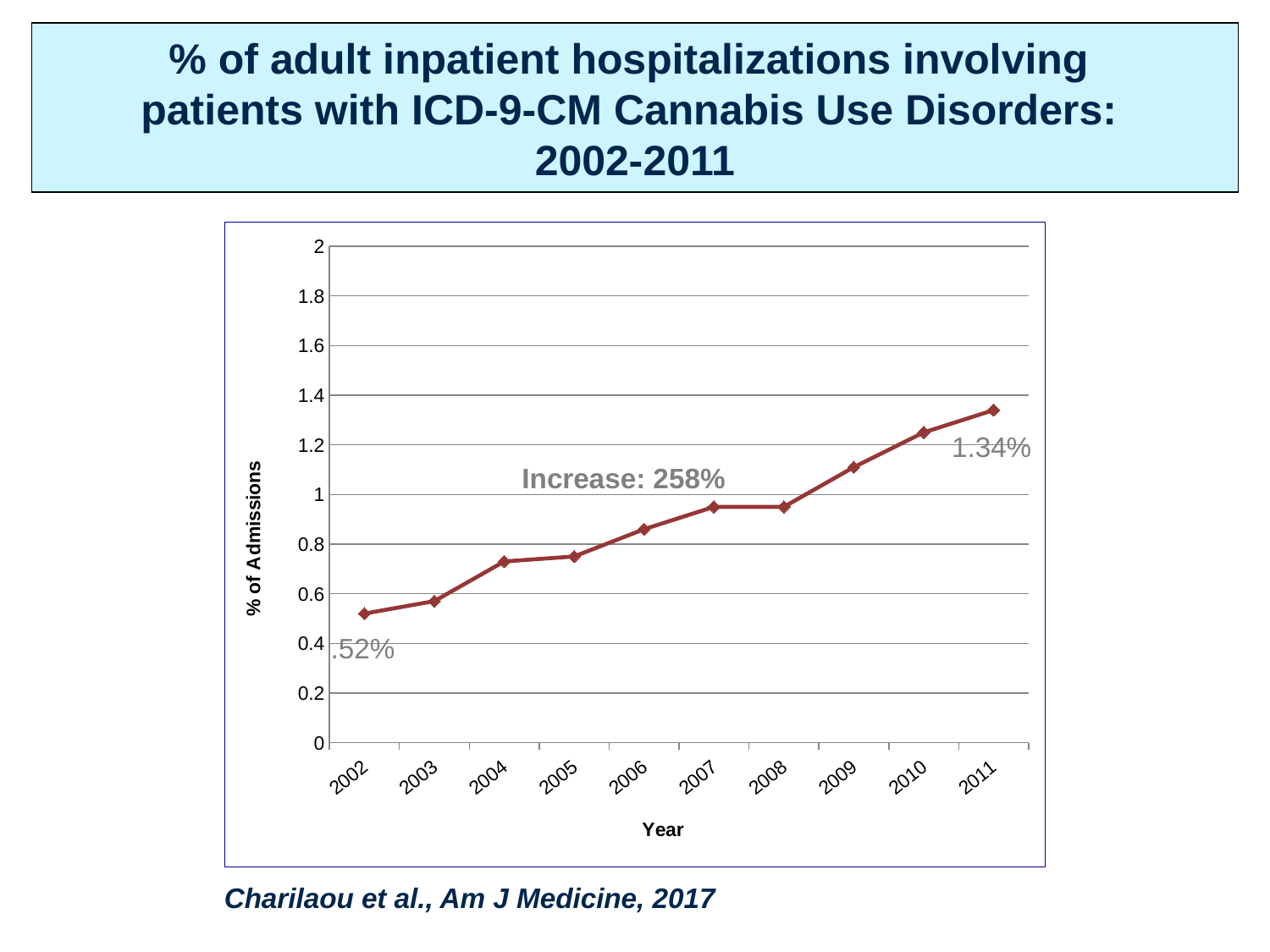
Is the value for 2004 greater or less than 0.6? greater Which year has the lowest % of admissions? 2002 Is the value for 2007 greater or less than 0.8? greater Which year has the highest % of admissions? 2011 What kind of chart is shown on the slide? Line chart How many years are plotted on the x axis? 10 Which year has the larger value, 2005 or 2010? 2010 What value is labelled for 2011 on the chart? 1.34% Is the value for 2009 greater or less than 1? greater Do the values generally rise or fall from 2002 to 2011? Rise What percentage increase is annotated on the chart? 258% What value is labelled for 2002 on the chart? .52%